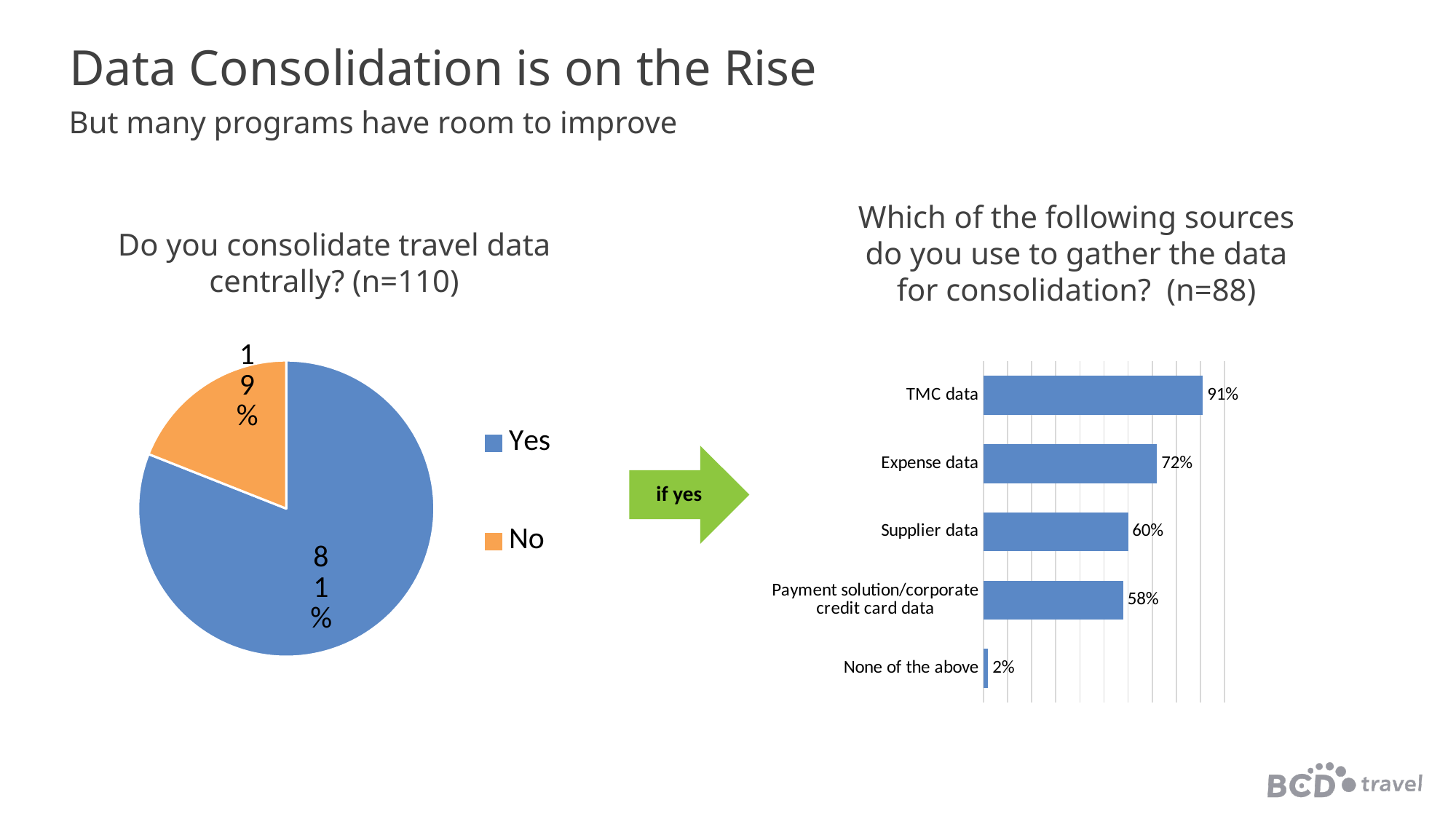
In the bar chart on the right, what is the value for Payment solution/corporate credit card data? 58% How many categories are shown in the bar chart on the right? 5 In the pie chart 'Do you consolidate travel data centrally?', what share of respondents answered Yes? 81% In the pie chart 'Do you consolidate travel data centrally?', what share of respondents answered No? 19% How many entries does the legend of the pie chart on the left list? 2 What kind of chart is the chart on the left of the slide? Pie chart In the bar chart on the right, what is the value for TMC data? 91% What kind of chart is the chart on the right of the slide? Bar chart In the bar chart on the right, which category has the lowest value? None of the above In the bar chart on the right, what is the difference between the values for TMC data and Expense data? 19% In the pie chart on the left, which answer has the larger share, Yes or No? Yes In the bar chart on the right, which source has the highest value? TMC data